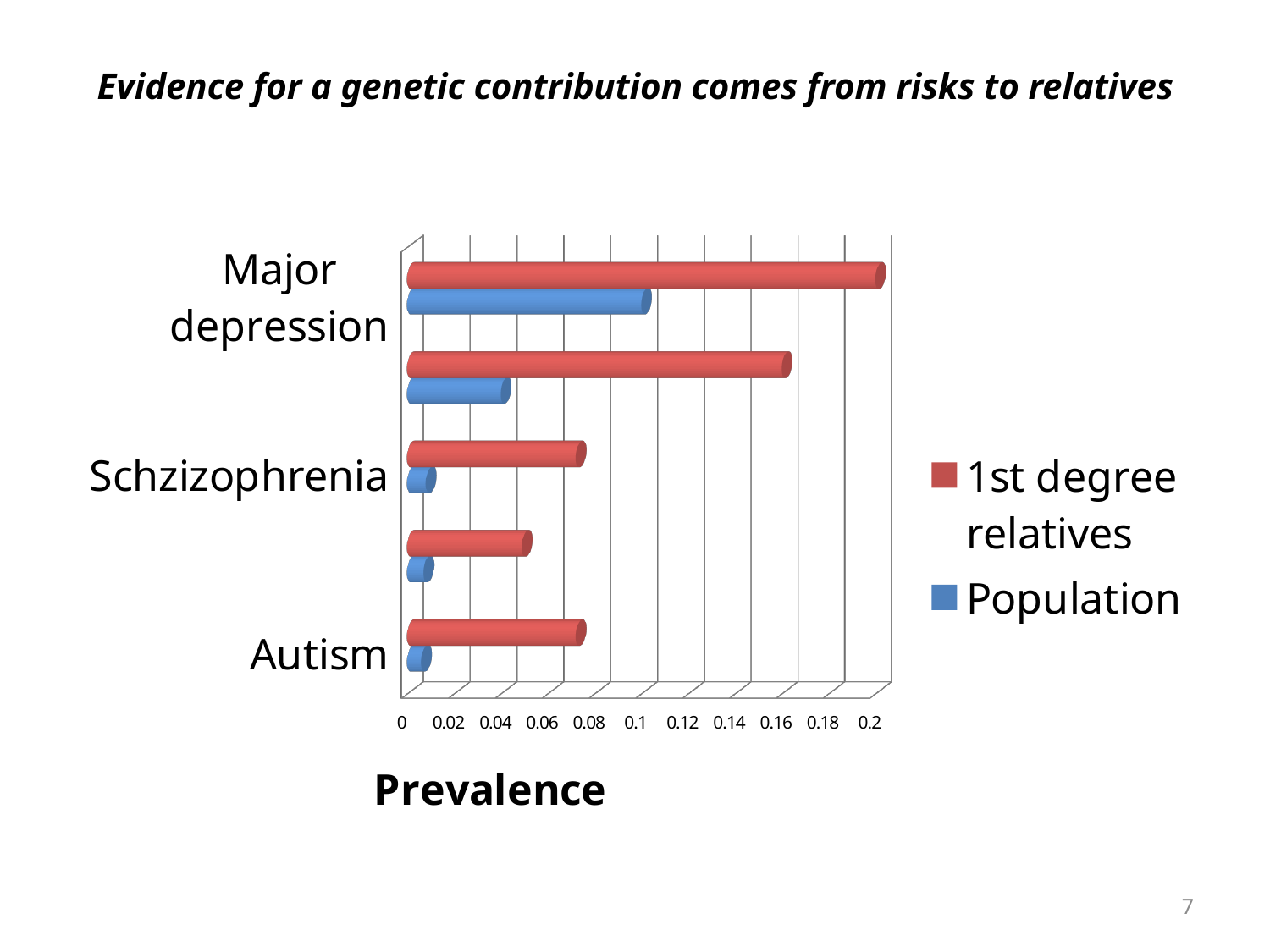
Is the Population value for Autism greater or less than 0.02? less Which has the larger 1st degree relatives value: Major depression or Schizophrenia? Major depression Among the labeled disorders, which has the highest 1st degree relatives prevalence? Major depression Is the 1st degree relatives value for Schizophrenia greater or less than 0.1? less What are the two series named in the legend? 1st degree relatives and Population Is the Population value for Major depression greater or less than 0.08? greater What kind of chart is shown on the slide? Bar chart What is the title of the horizontal axis? Prevalence For Major depression, which is larger: the 1st degree relatives value or the Population value? 1st degree relatives How many series does the legend list? 2